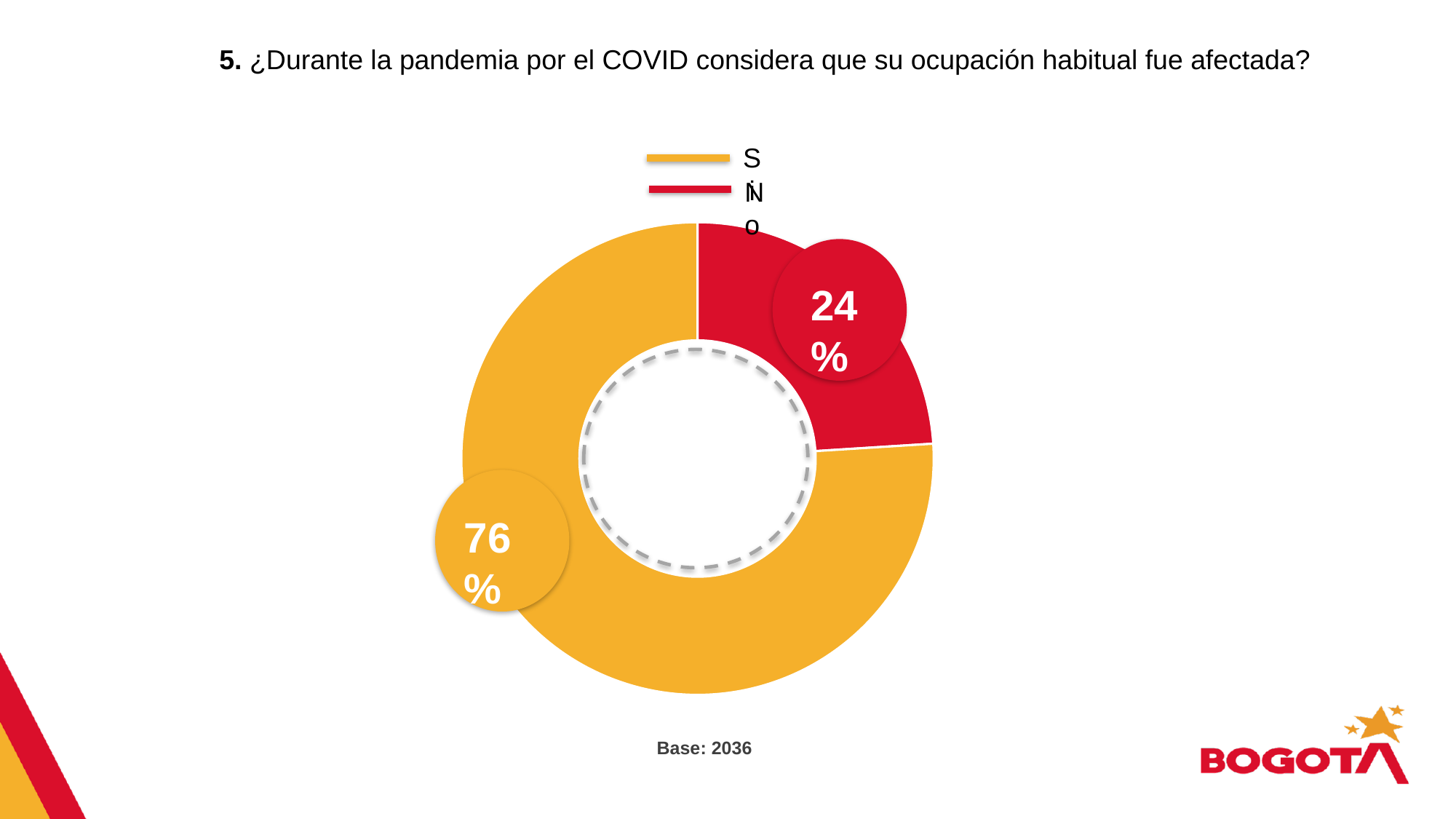
Is the share for "Sí" larger or smaller than the share for "No"? larger What is the base (number of respondents) stated below the chart? 2036 What percentage of respondents answered "No"? 24% What percentage of respondents answered "Sí"? 76% Which response has the larger share of the chart? Sí What share of the pie does the "No" slice represent? 24% What colour is used for the "Sí" slice? Yellow What is the difference in percentage points between the "Sí" and "No" shares? 52 What kind of chart is shown on the slide? Pie (donut) chart How many entries does the legend list? 2 Which response has the smaller share of the chart? No How many categories are shown in the chart? 2